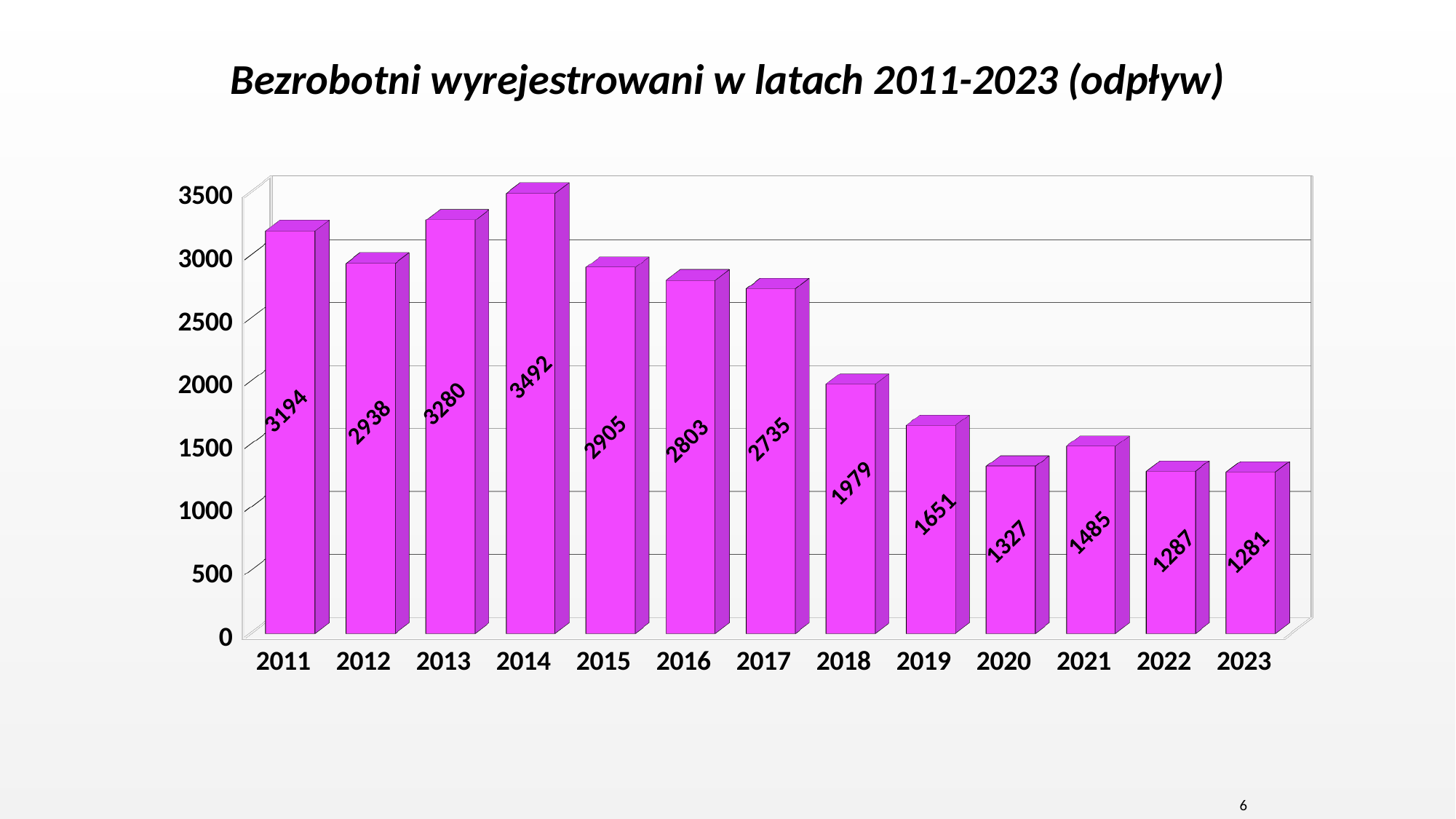
How many years are shown on the x axis? 13 Which year has the highest value? 2014 What is the value for 2023? 1281 What is the title of the chart? Bezrobotni wyrejestrowani w latach 2011-2023 (odpływ) Is the value for 2018 greater or less than 2000? less What is the value for 2014? 3492 What is the difference between the values for 2014 and 2015? 587 What is the value for 2019? 1651 What is the difference between the values for 2017 and 2018? 756 What kind of chart is shown on the slide? bar chart Which year has the lowest value? 2023 Which is larger, the value for 2012 or the value for 2013? 2013